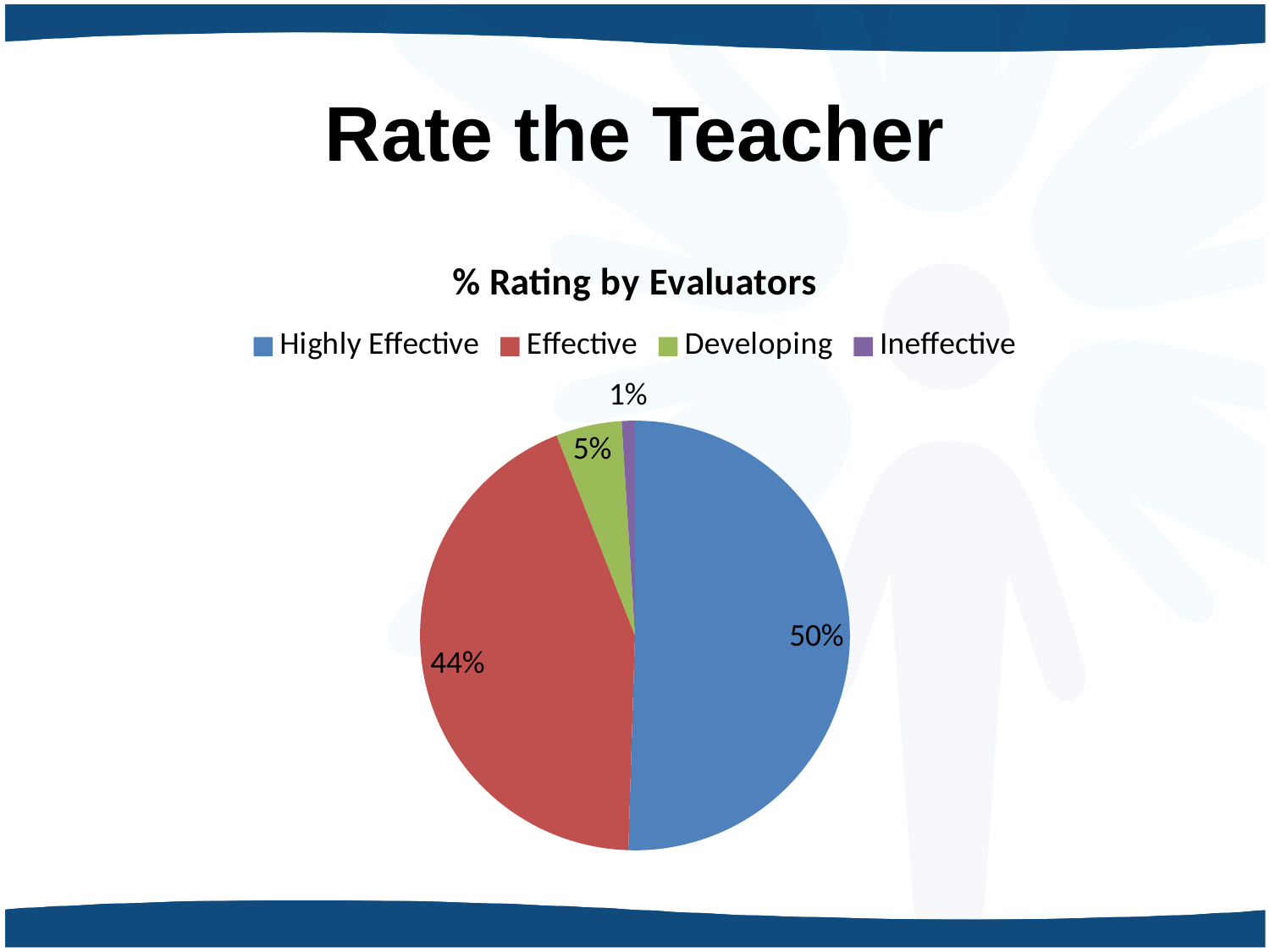
What is the difference in percentage points between Highly Effective and Effective? 6 What percentage of ratings were Highly Effective? 50% Which rating category has the largest share of the pie? Highly Effective What is the title of the chart? % Rating by Evaluators What percentage of ratings were Developing? 5% How many rating categories are shown in the pie chart? 4 What kind of chart is shown on the slide? Pie chart Which rating category has the smallest share of the pie? Ineffective What percentage of ratings were Effective? 44% What percentage of ratings were Ineffective? 1% What colour represents the Effective category in the pie chart? Red Which is larger, the share for Developing or the share for Ineffective? Developing